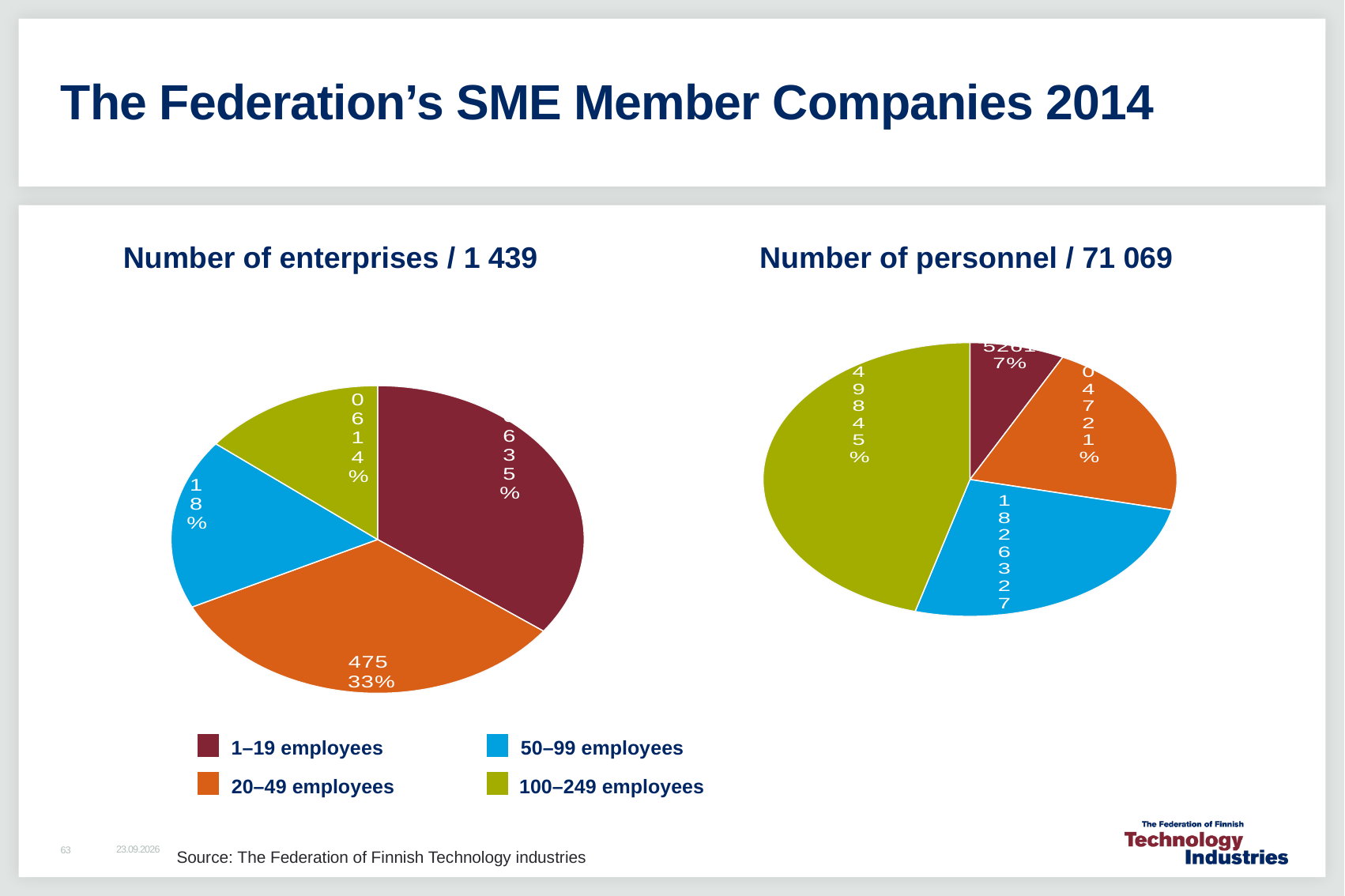
In the Number of personnel chart, which size category has the largest slice? 100–249 employees In the Number of enterprises chart, which size category has the largest slice? 1–19 employees How many slices does the Number of personnel pie chart on the right have? 4 What total number of personnel is given in the title of the right-hand chart? 71 069 In the Number of enterprises chart, which is larger: the slice for 20–49 employees or the slice for 50–99 employees? 20–49 employees What kind of chart is used for the Number of enterprises chart on the left? Pie chart In the Number of enterprises chart, how many enterprises have 20–49 employees? 475 In the Number of personnel chart, what share of personnel is in companies with 1–19 employees? 7% How many categories does the legend list? 4 In the Number of enterprises chart, what share of enterprises have 20–49 employees? 33% In the Number of personnel chart, which size category has the smallest slice? 1–19 employees In the Number of enterprises chart, what share of enterprises have 50–99 employees? 18%